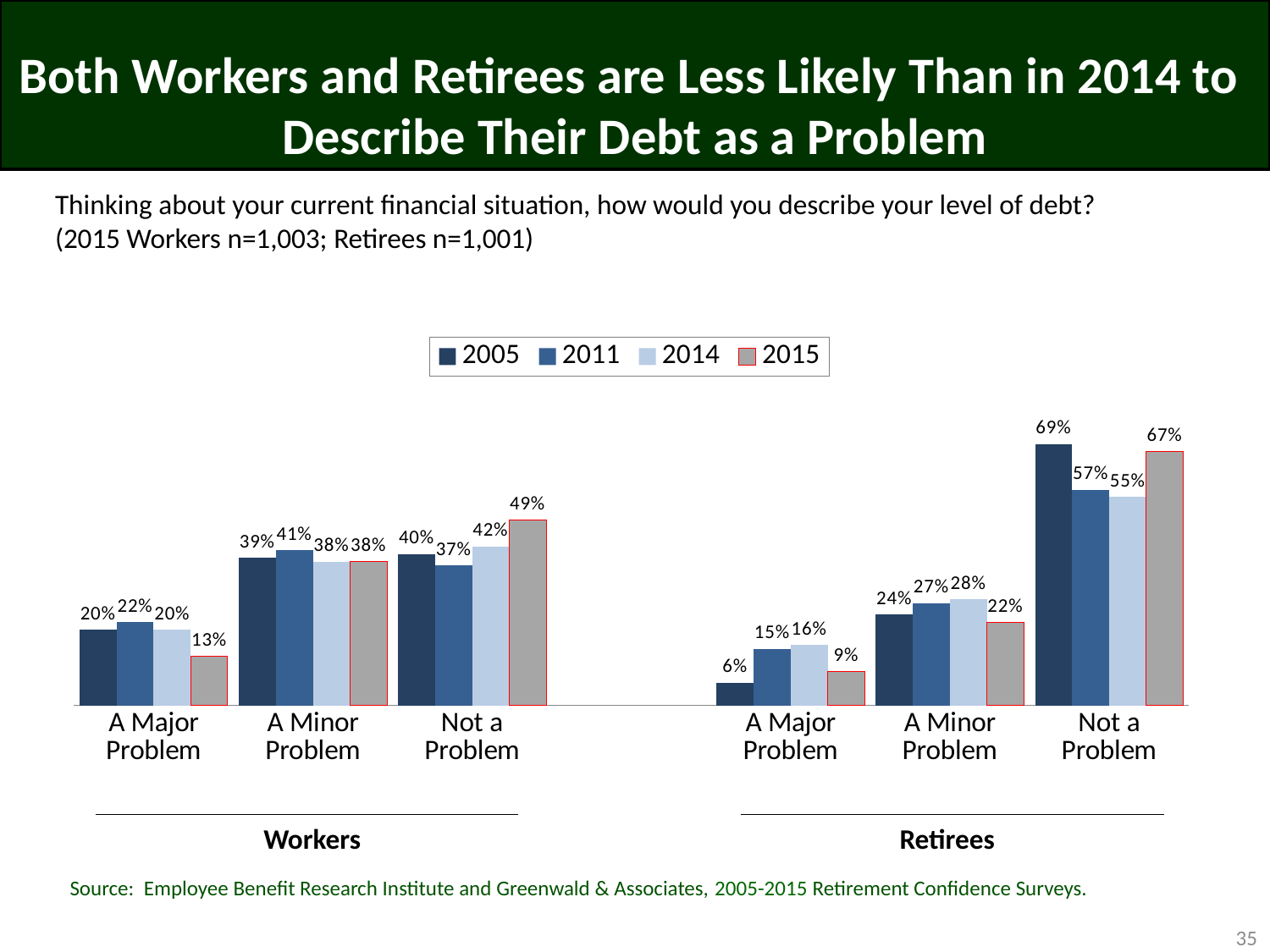
Which is larger: the 2015 value for Workers 'A Minor Problem' or the 2015 value for Retirees 'A Minor Problem'? Workers 'A Minor Problem' Among the Workers 'Not a Problem' bars, which year has the highest value? 2015 What kind of chart is shown on the slide? Bar chart What percentage of Retirees described their debt as a minor problem in 2014? 28% Which year's bars are shown in the lightest blue colour? 2014 What percentage of Retirees said their debt was not a problem in 2005? 69% What percentage of Workers described their debt as a major problem in 2015? 13% How many response categories are shown for the Retirees group? 3 How many series does the legend list? 4 What is the difference between the 2005 and 2015 values for Retirees who said debt is not a problem? 2% Among the Retirees 'A Major Problem' bars, which year has the lowest value? 2005 What is the difference between the 2014 and 2015 values for Workers who said debt is not a problem? 7%